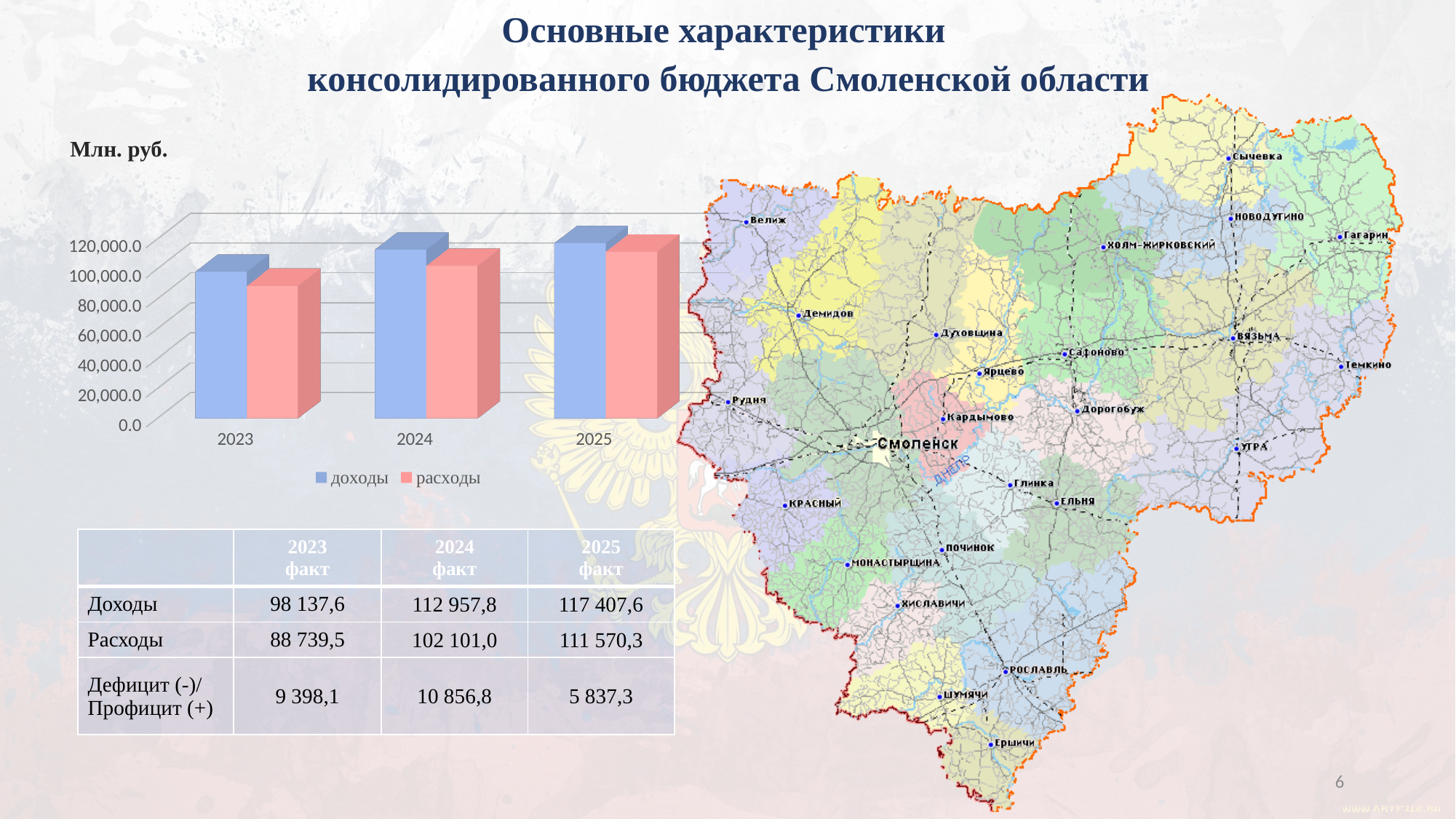
In 2023, which is larger, доходы or расходы? доходы How many years are shown on the x axis of the chart? 3 Is the value for расходы in 2025 greater or less than 100,000.0? greater Is the value for доходы in 2024 greater or less than 100,000.0? greater What are the two series named in the chart legend? доходы and расходы What kind of chart is shown on the slide? bar chart How many series does the chart legend list? 2 What unit is stated above the chart? Млн. руб. Which year has the lowest расходы bar? 2023 Do the доходы values rise or fall from 2023 to 2025? rise Is the value for расходы in 2023 greater or less than 100,000.0? less Which year has the highest доходы bar? 2025